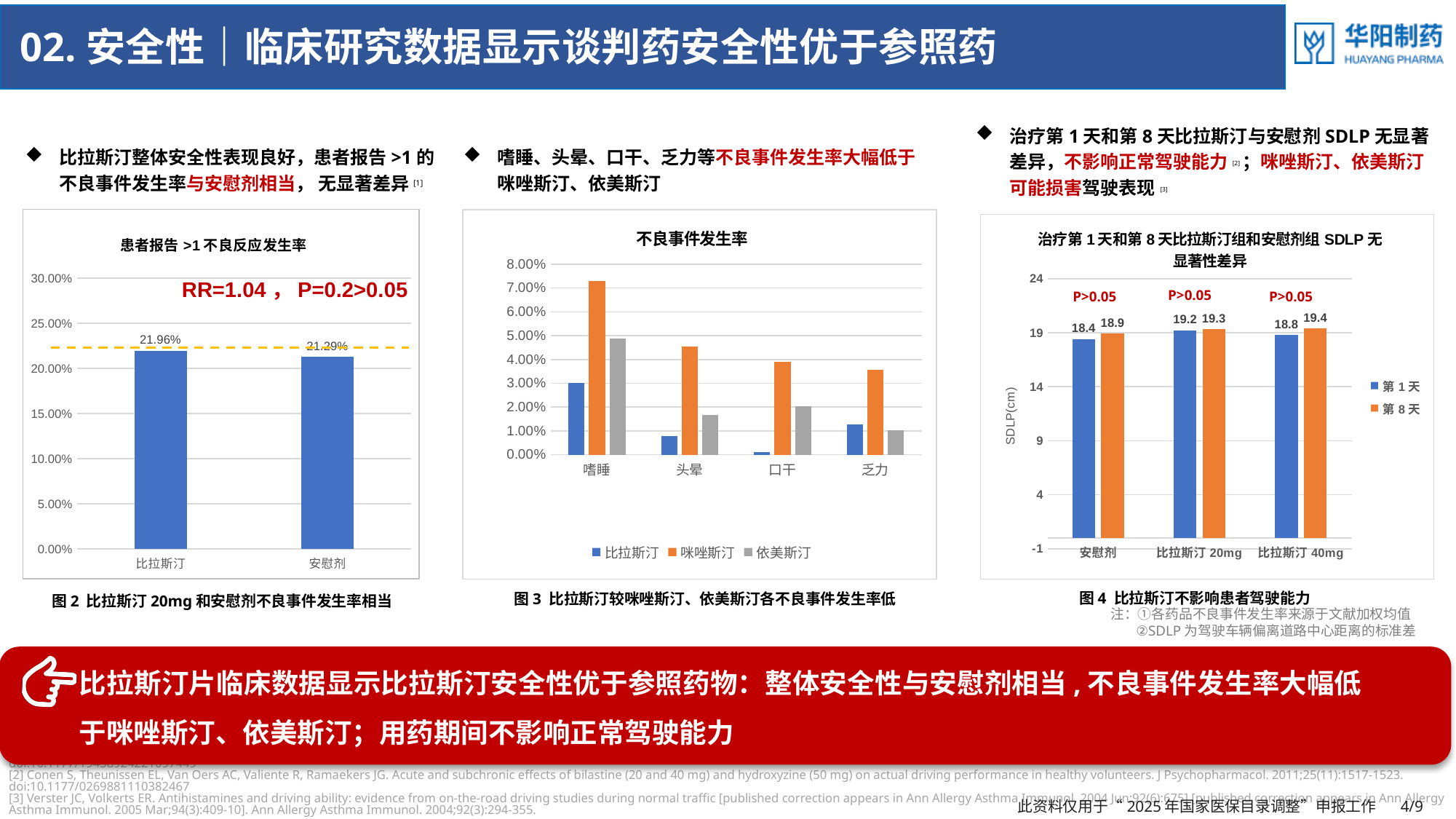
In the left chart titled 患者报告>1不良反应发生率, what is the value for 安慰剂? 21.29% In the middle chart titled 不良事件发生率, is the value of 比拉斯汀 for 口干 greater or less than 1.00%? less In the middle chart titled 不良事件发生率, which series has the highest value for 嗜睡? 咪唑斯汀 In the middle chart titled 不良事件发生率, how many series does the legend list? 3 In the middle chart titled 不良事件发生率, is the value of 咪唑斯汀 for 嗜睡 greater or less than 7.00%? greater In the right chart about SDLP, what is the 第1天 value for 安慰剂? 18.4 In the right chart about SDLP, what is the difference between the 第1天 and 第8天 values for 安慰剂? 0.5 In the left chart titled 患者报告>1不良反应发生率, what is the value for 比拉斯汀? 21.96% In the middle chart titled 不良事件发生率, what kind of chart is it? bar chart In the left chart titled 患者报告>1不良反应发生率, what is the difference between the 比拉斯汀 and 安慰剂 values? 0.67% In the right chart about SDLP, what is the 第8天 value for 比拉斯汀 40mg? 19.4 In the left chart titled 患者报告>1不良反应发生率, how many categories are shown on the x axis? 2